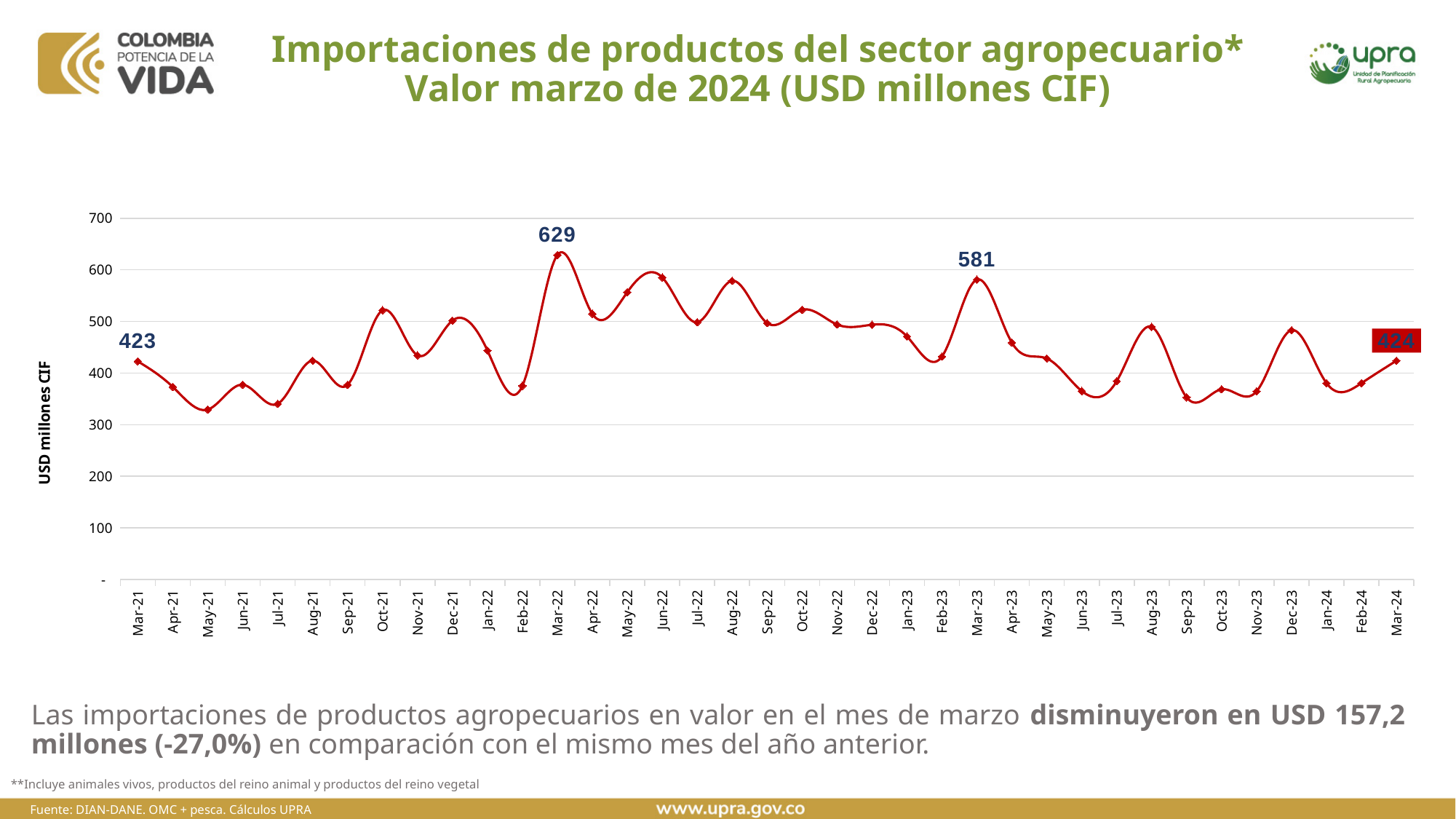
What is the difference between the values for Mar-22 and Mar-23? 48 What is the value for Mar-21? 423 What is the value for Mar-24? 424 Which month has the lowest value on the chart? May-21 What is the difference between the values for Mar-22 and Mar-21? 206 What kind of chart is shown on the slide? line chart How many monthly data points are plotted on the chart? 37 What is the value for Mar-22? 629 Which is larger, the value for Mar-23 or the value for Mar-24? Mar-23 Is the value for Oct-21 greater or less than 500? greater Which month has the highest value on the chart? Mar-22 What is the value for Mar-23? 581